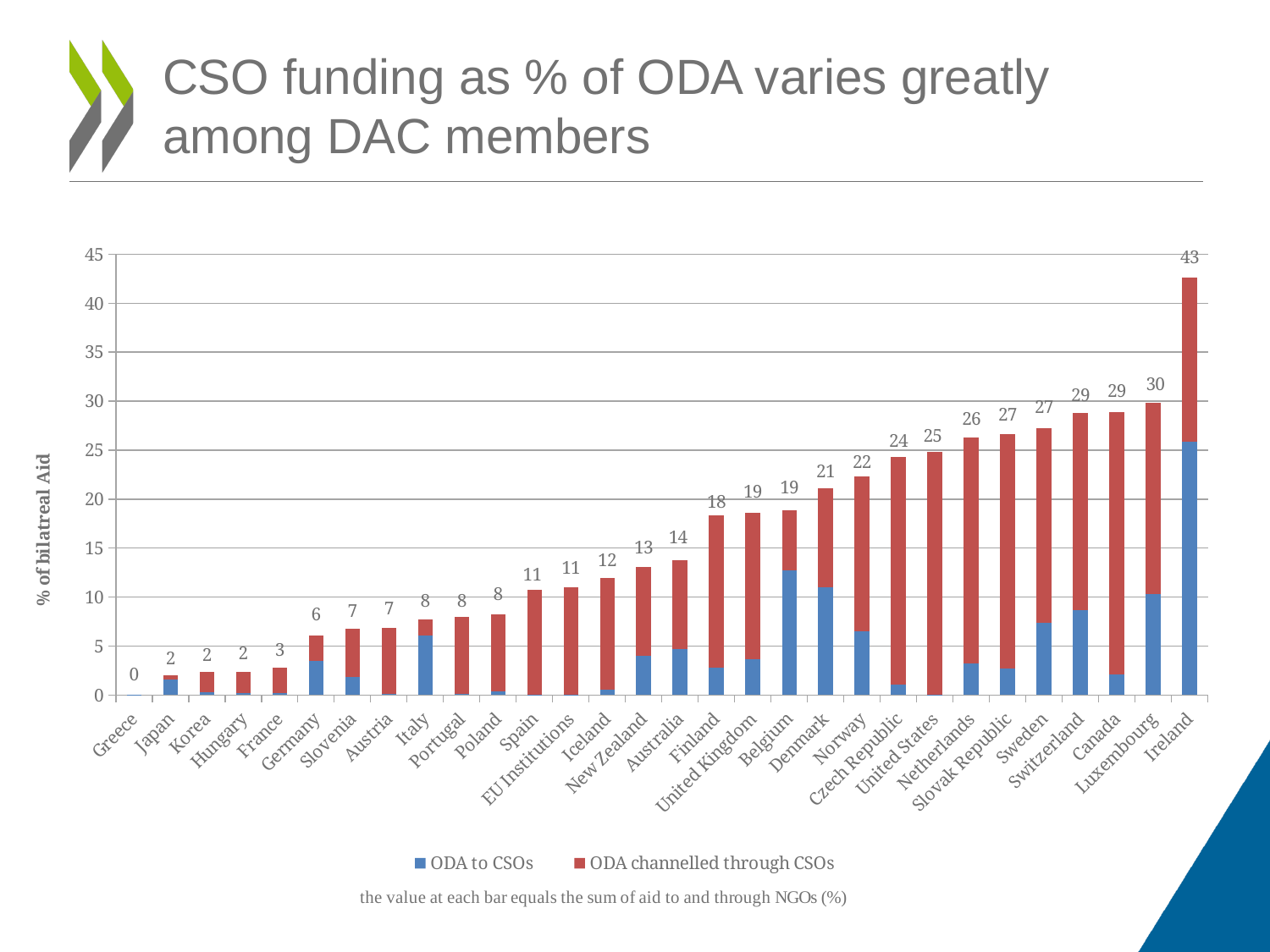
Is the 'ODA to CSOs' value for Belgium greater or less than 10? greater How many series does the legend list? 2 Which country has the highest total CSO funding as % of bilateral aid? Ireland What is the label of the y axis? % of bilatreal Aid How many countries or institutions are shown on the x axis? 30 Do the labelled totals rise or fall moving from left to right along the x axis? Rise What is the difference between the labelled totals for Ireland and Luxembourg? 13 Which country has the lowest total value on the chart? Greece What type of chart is shown on the slide? Stacked bar chart Which has a larger labelled total, Finland or Norway? Norway What is the total value labelled for Ireland? 43 What is the total value labelled for Denmark? 21